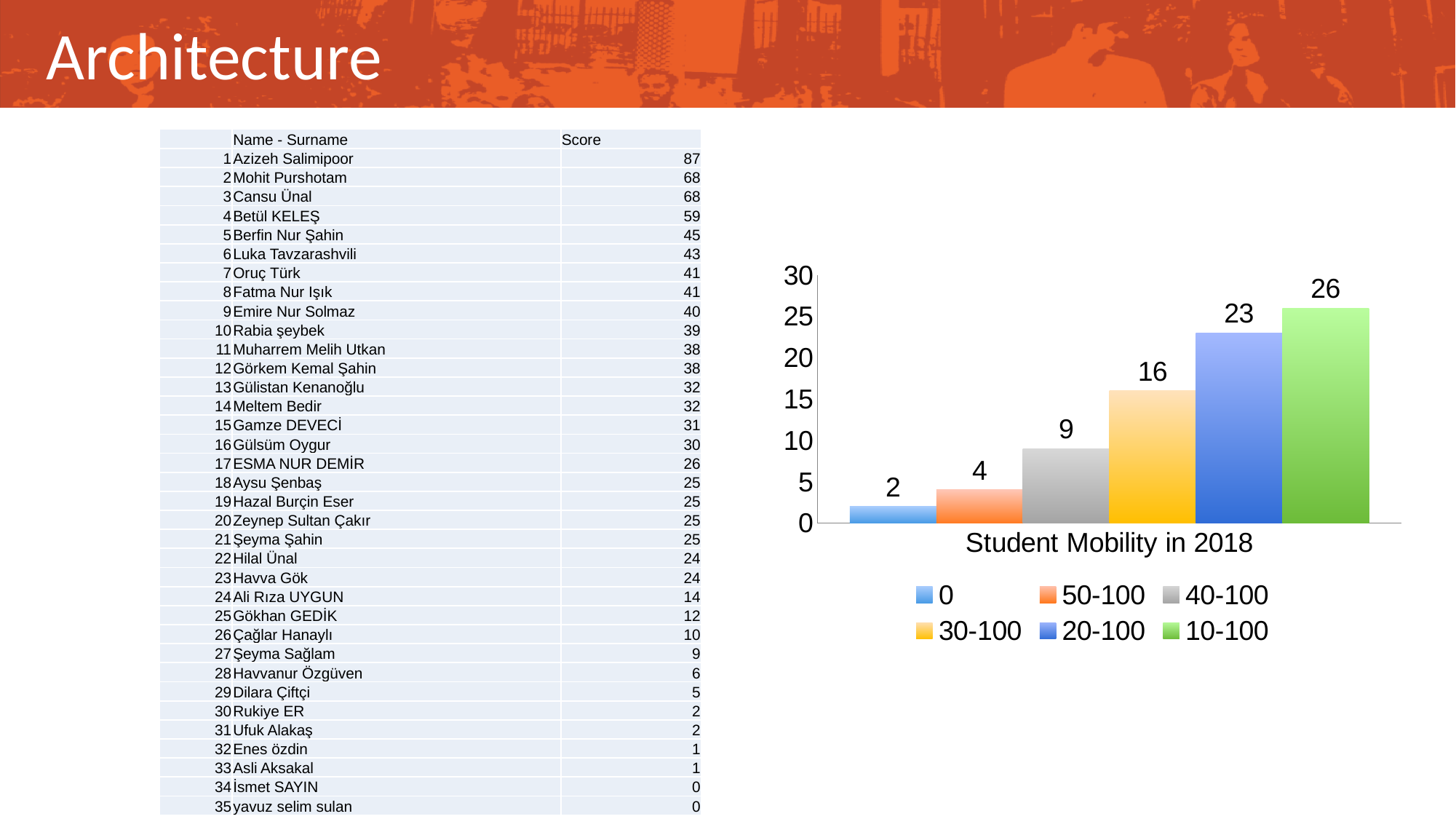
What is the category label shown below the bars on the x axis? Student Mobility in 2018 What type of chart is shown on the slide? bar chart What colour is the bar for the 20-100 series? blue What is the value of the 10-100 series in the chart? 26 How many series does the chart legend list? 6 What is the value of the 30-100 series in the chart? 16 Which is larger in the chart, the 30-100 value or the 40-100 value? 30-100 Which series has the lowest value in the chart? 0 What is the value of the 0 series in the chart? 2 What is the value of the 40-100 series in the chart? 9 What is the difference between the 20-100 and 50-100 values in the chart? 19 Which series has the highest value in the chart? 10-100